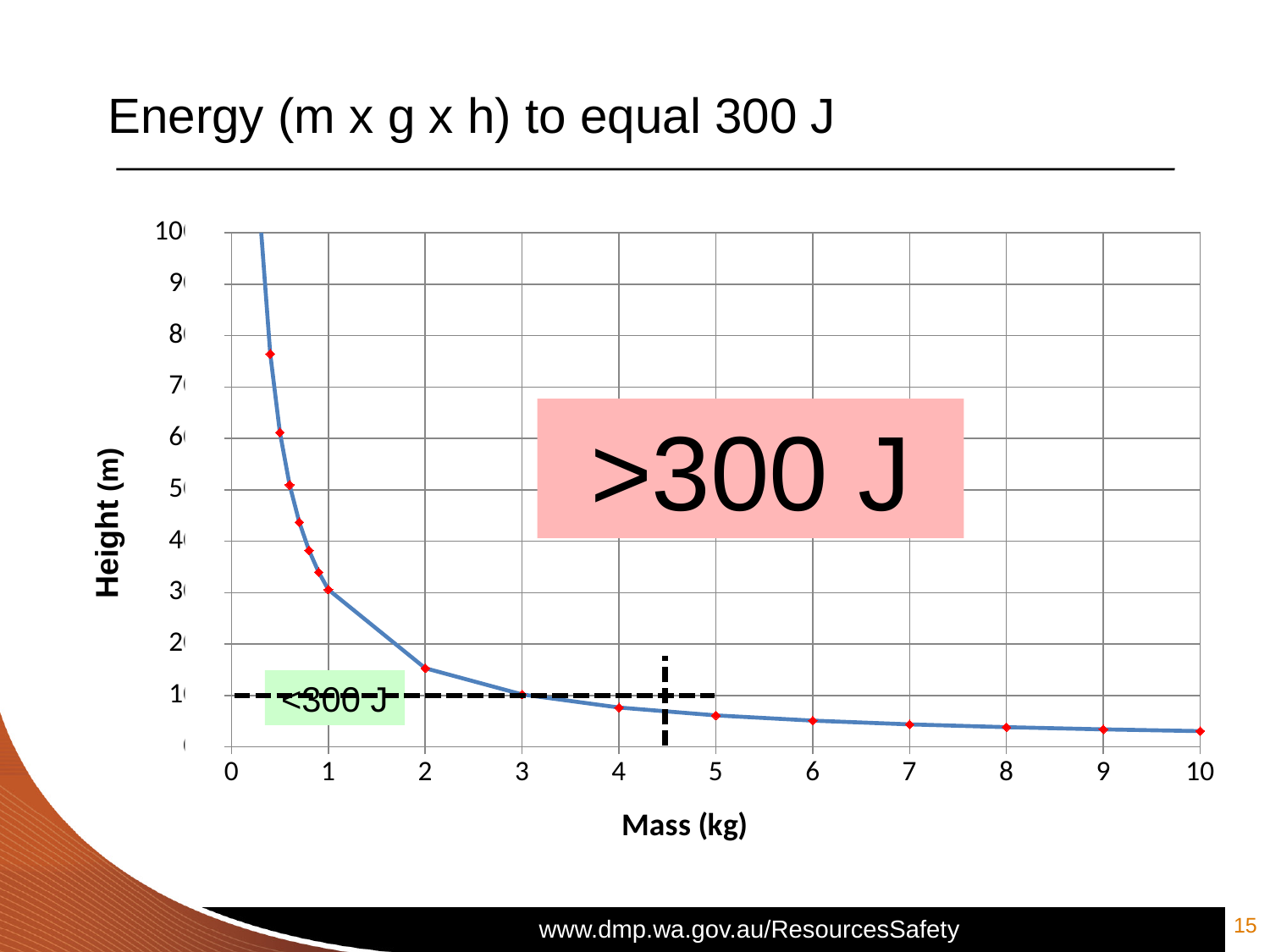
At which mass on the x axis is the plotted height lowest? 10 kg Which has the larger height value: a mass of 1 kg or a mass of 3 kg? 1 kg Is the height value at a mass of 1 kg greater or less than 2? greater Which has the larger height value: a mass of 2 kg or a mass of 4 kg? 2 kg What kind of chart is shown on the slide? line chart What is the title of the x axis? Mass (kg) Is the height value at a mass of 2 kg greater or less than 1? greater Does the height rise or fall as mass increases along the x axis? fall What is the title of the y axis? Height (m)